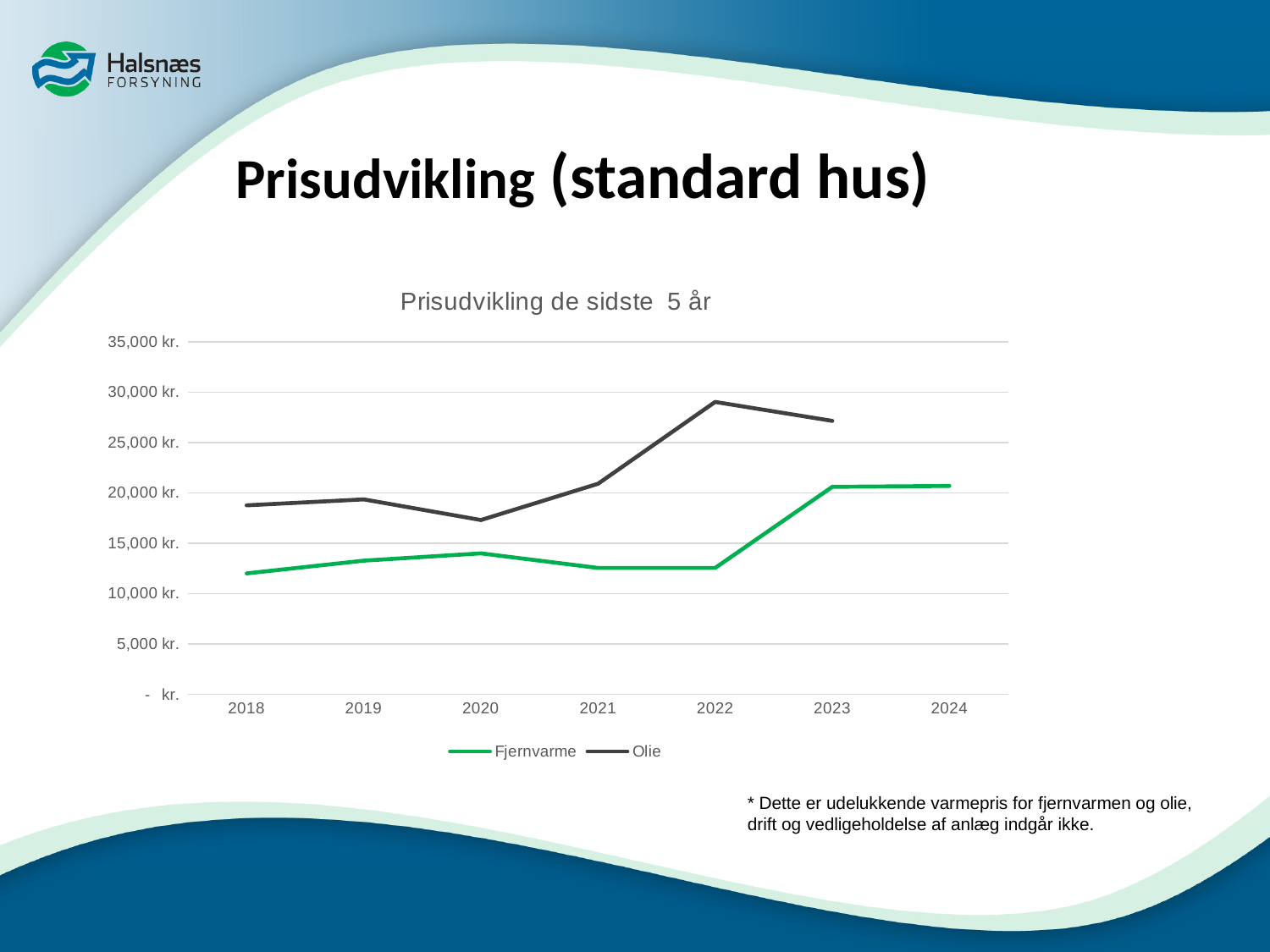
What kind of chart is shown on the slide? line chart Is the value for Fjernvarme in 2018 greater or less than 15,000 kr.? less Is the value for Olie in 2022 greater or less than 25,000 kr.? greater In 2022, which series has the larger value, Fjernvarme or Olie? Olie In which year does the Olie series reach its lowest value? 2020 Is the value for Olie in 2020 greater or less than 20,000 kr.? less How many series does the legend list? 2 In which year does the Olie series reach its highest value? 2022 What is the title of the chart? Prisudvikling de sidste 5 år Does the Fjernvarme series rise or fall from 2022 to 2023? rise Which two series are listed in the legend? Fjernvarme and Olie How many years are shown on the x axis? 7